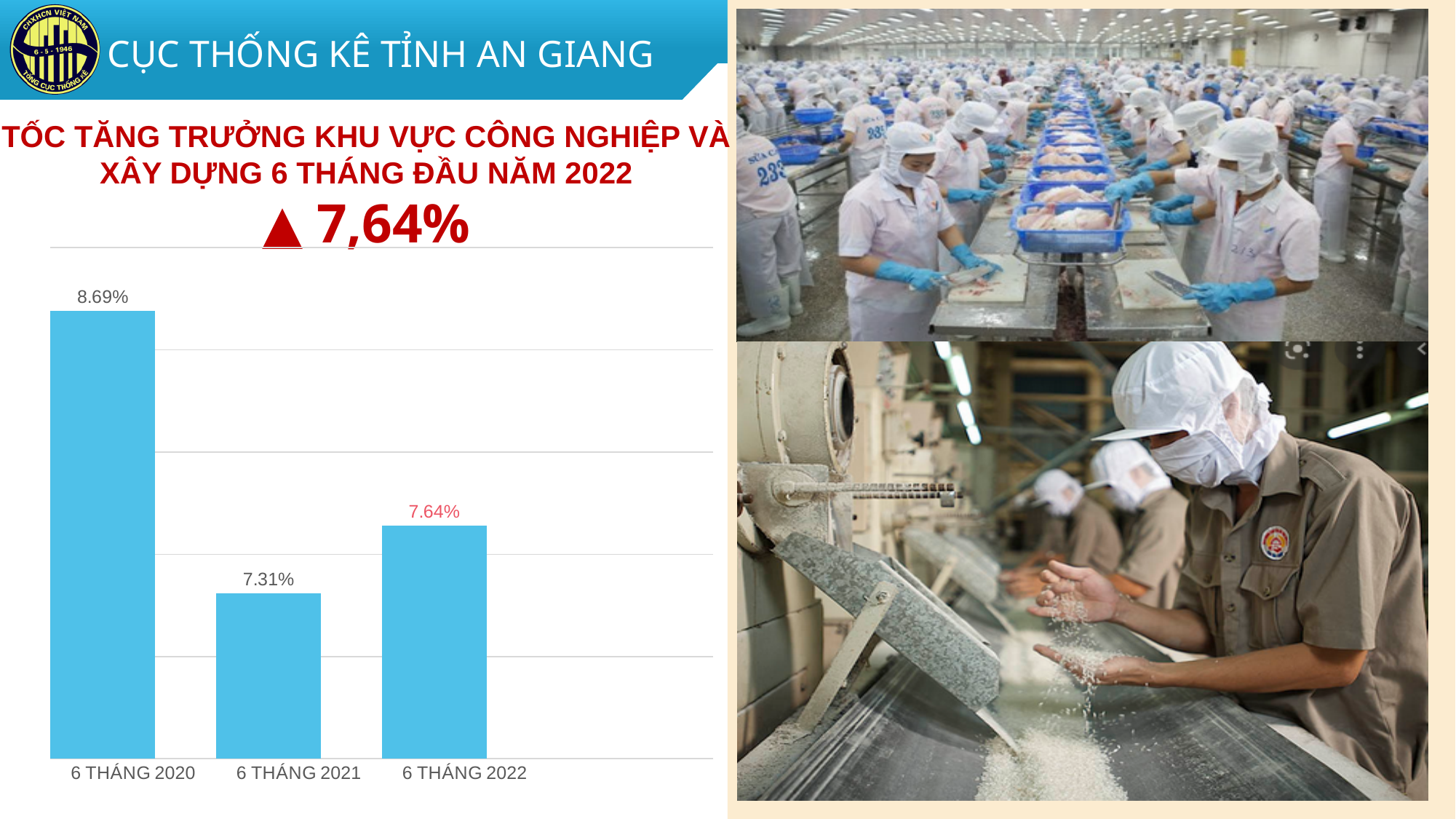
What is the value for 6 THÁNG 2021? 7.31% What kind of chart is shown on the slide? Bar chart Which period has the highest value? 6 THÁNG 2020 What is the difference between the values for 6 THÁNG 2022 and 6 THÁNG 2021? 0.33% What is the value for 6 THÁNG 2022? 7.64% What colour are the bars in the chart? Light blue Does the value rise or fall from 6 THÁNG 2021 to 6 THÁNG 2022? Rise Which period has the lowest value? 6 THÁNG 2021 What is the value for 6 THÁNG 2020? 8.69% Which is larger, the value for 6 THÁNG 2021 or 6 THÁNG 2022? 6 THÁNG 2022 How many bars are shown in the chart? 3 What is the difference between the values for 6 THÁNG 2020 and 6 THÁNG 2021? 1.38%